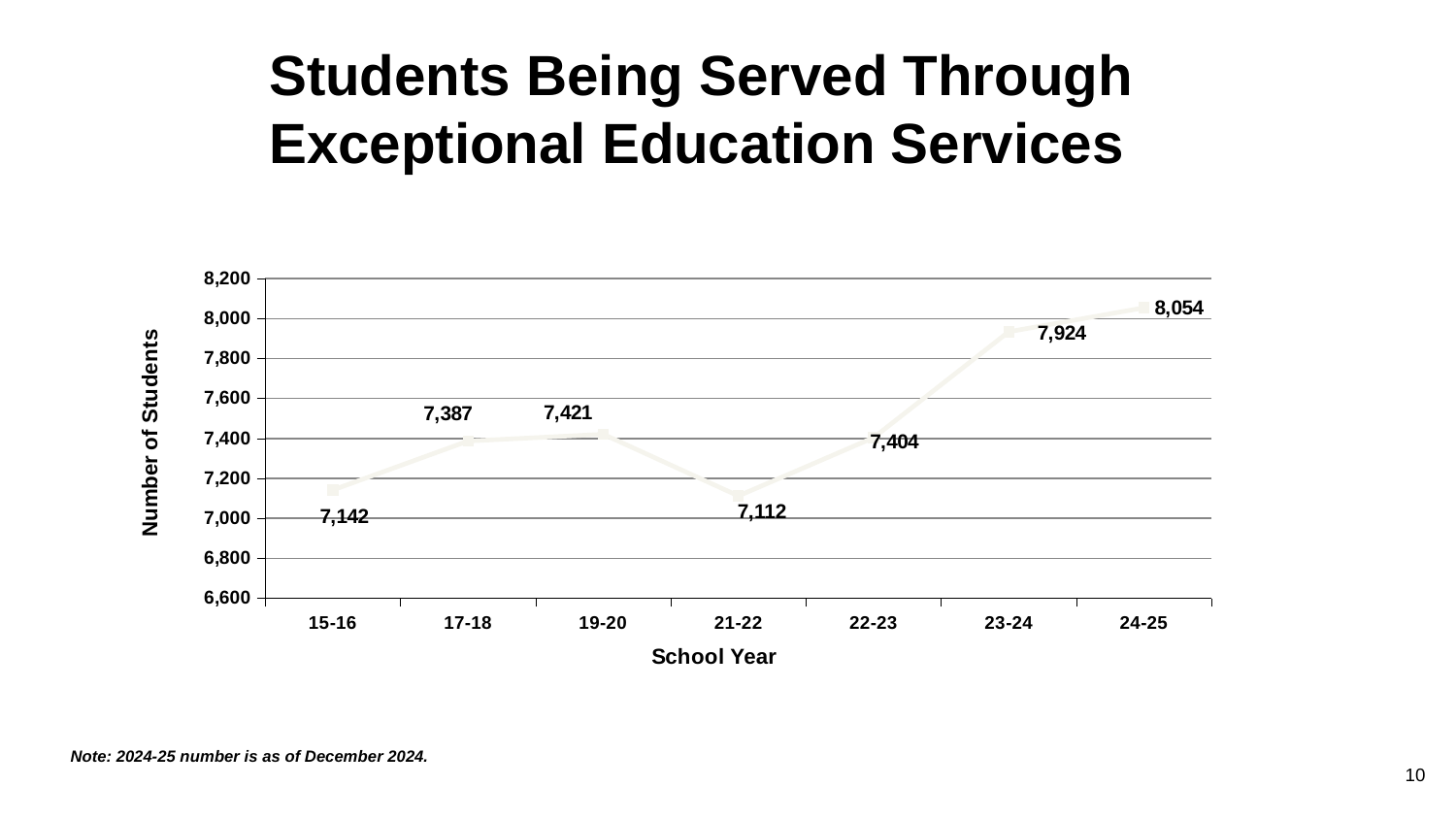
What kind of chart is shown on the slide? line chart What is the number of students for school year 24-25? 8,054 Which school year has the lowest number of students? 21-22 What is the difference in number of students between 24-25 and 23-24? 130 How many school years are plotted on the chart? 7 Is the value for 23-24 greater or less than 7,800? greater What is the number of students for school year 21-22? 7,112 What is the label of the vertical axis? Number of Students Which school year has the highest number of students? 24-25 What is the difference in number of students between 19-20 and 21-22? 309 Which school year has more students, 15-16 or 22-23? 22-23 What is the number of students for school year 17-18? 7,387